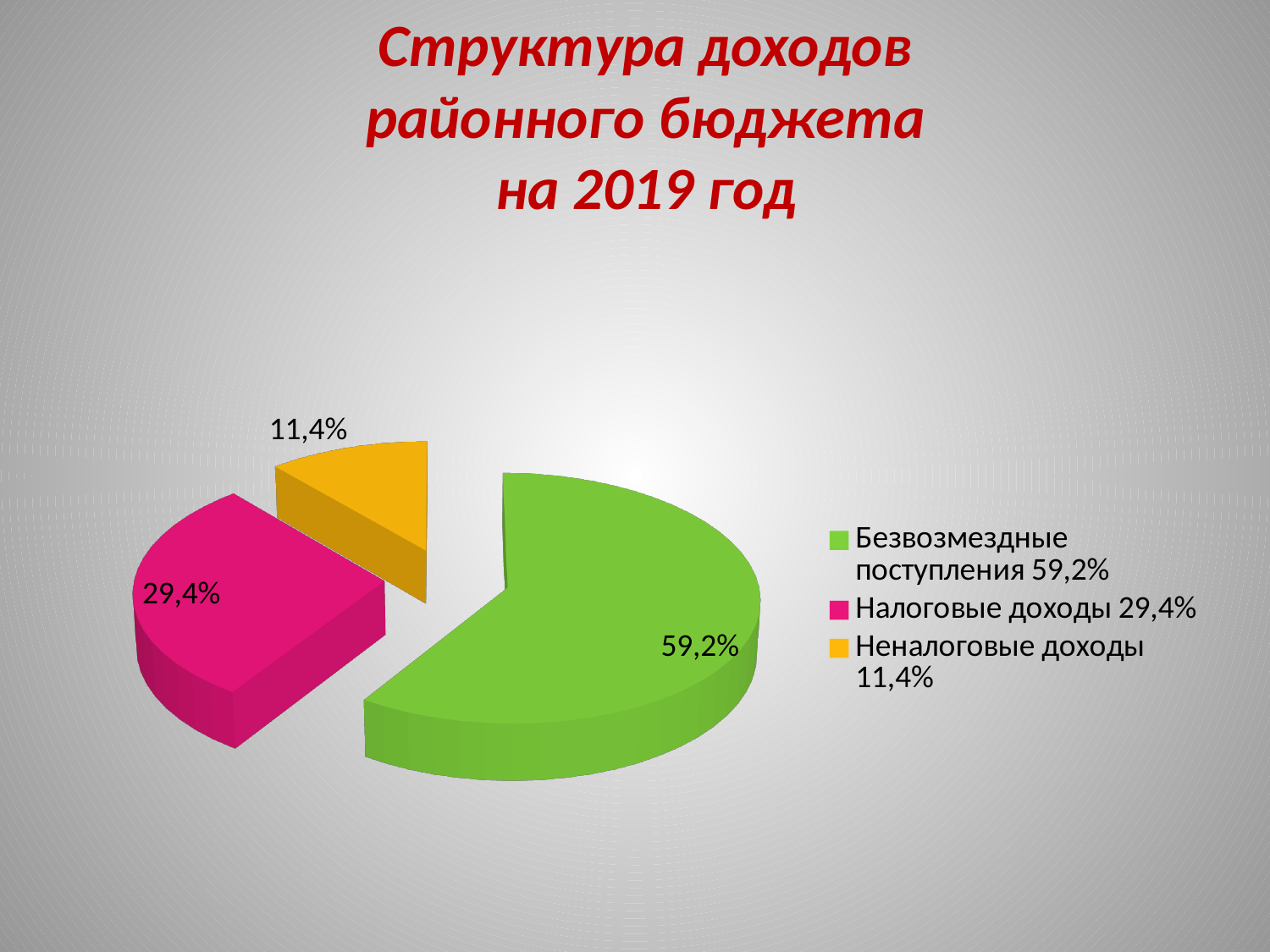
How many slices does the pie chart have? 3 Which is larger, Налоговые доходы or Неналоговые доходы? Налоговые доходы Which category has the smallest slice of the pie? Неналоговые доходы What is the difference in percentage points between Безвозмездные поступления and Налоговые доходы? 29,8 What kind of chart is shown on the slide? Pie chart What share of the pie does Безвозмездные поступления have? 59,2% What is the value shown for Налоговые доходы? 29,4% What is the title of the chart on the slide? Структура доходов районного бюджета на 2019 год What is the difference in percentage points between Налоговые доходы and Неналоговые доходы? 18 Which category has the largest slice of the pie? Безвозмездные поступления What is the value shown for Неналоговые доходы? 11,4% What colour is the slice for Налоговые доходы? Pink